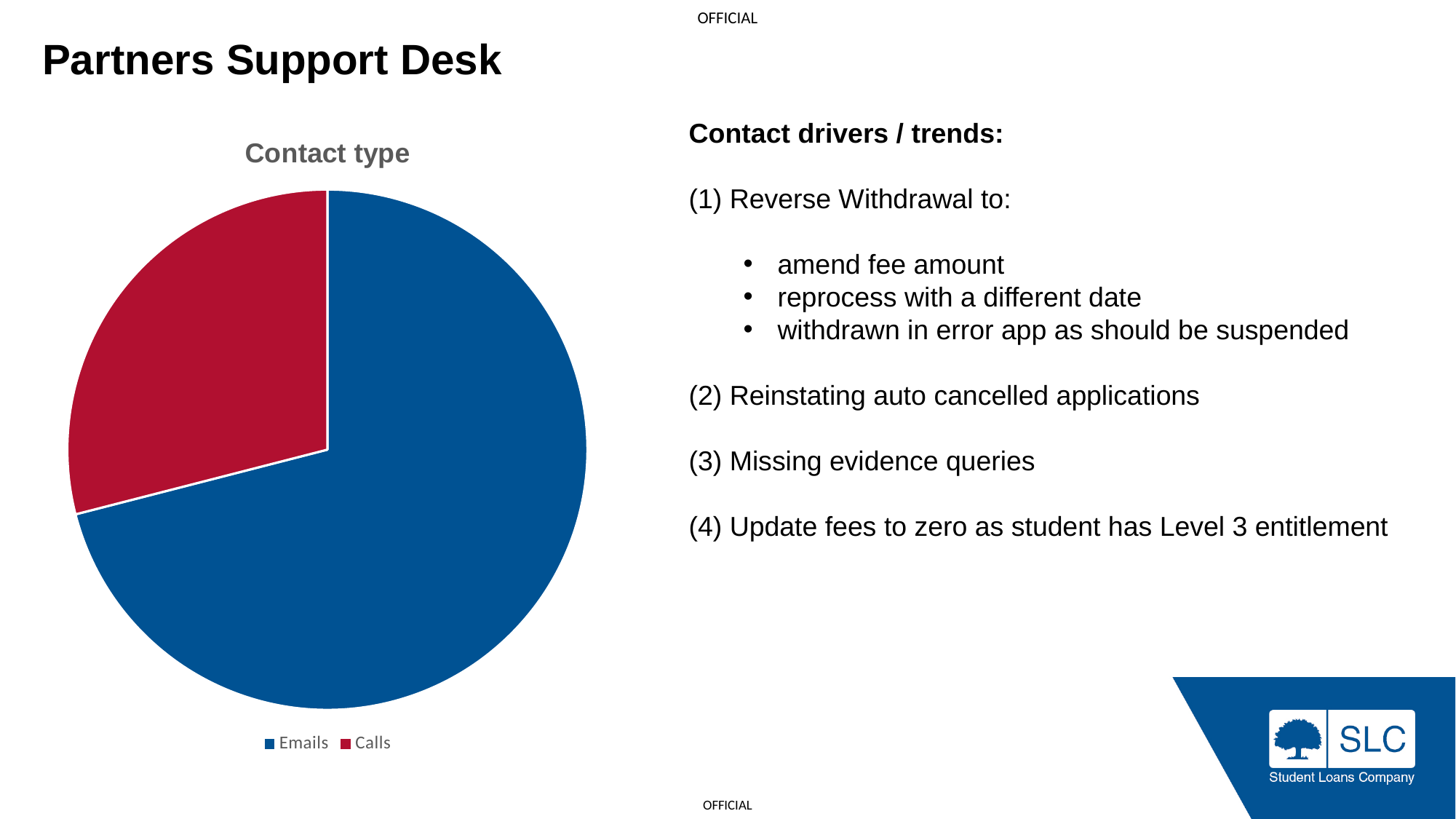
Which contact type has the largest share of the pie? Emails How many slices does the pie chart have? 2 What colour is the Calls slice in the pie chart? red What kind of chart is shown on the slide? pie chart Which is larger, the share for Emails or the share for Calls? Emails How many series does the chart legend list? 2 Which contact type has the smallest share of the pie? Calls What is the title of the chart? Contact type